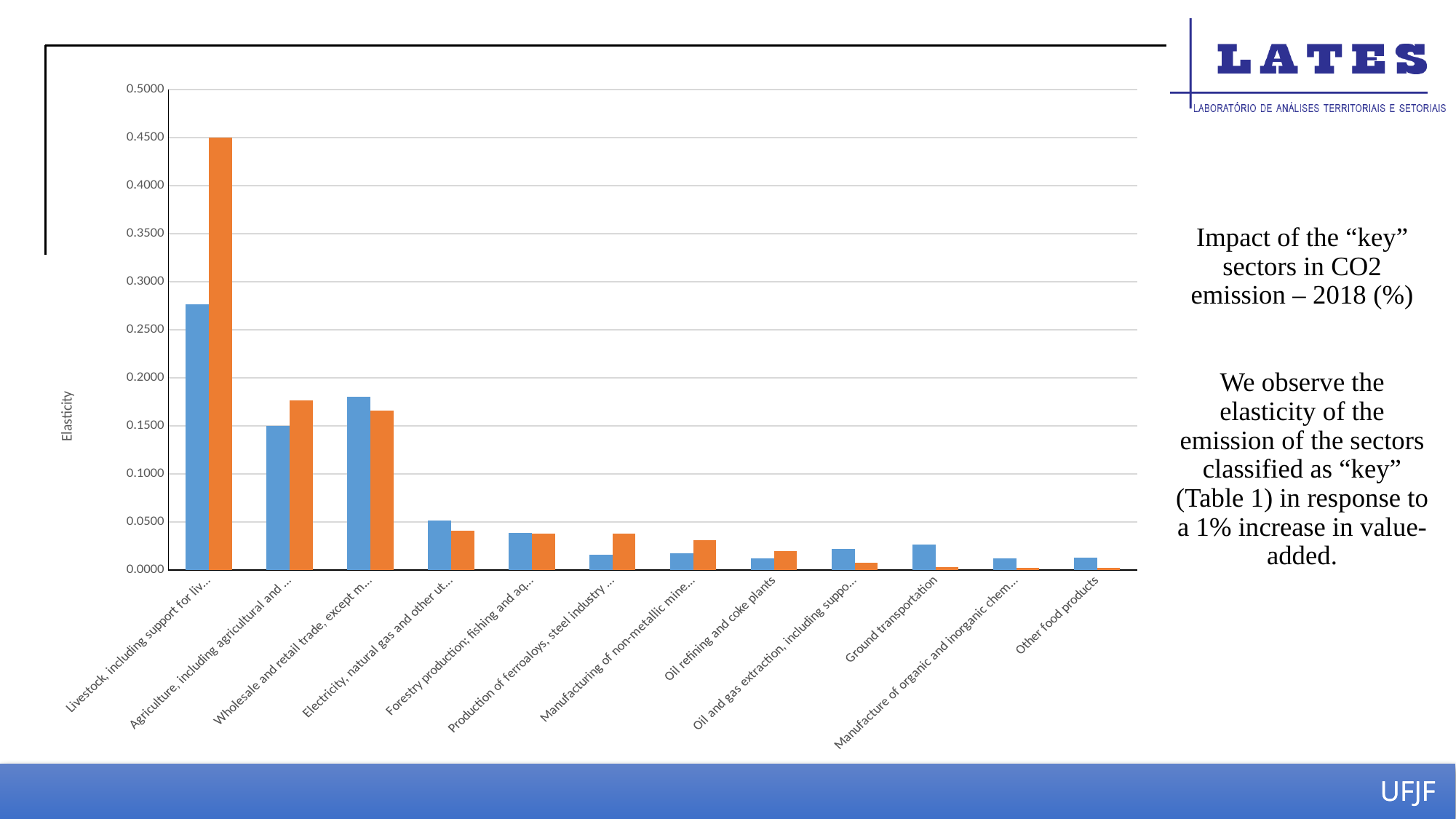
For Ground transportation, which bar is taller, the blue one or the orange one? blue What is the label of the vertical axis of the chart? Elasticity Is the orange bar for Ground transportation greater or less than 0.0500? less Which category has the tallest bar in the chart? Livestock, including support for liv... Do the bar heights generally rise or fall moving from left to right along the x axis? fall How many sector categories are shown on the x axis of the chart? 12 For Livestock, including support for liv..., which bar is taller, the blue one or the orange one? orange Is the blue bar for Livestock, including support for liv... greater or less than 0.3000? less What kind of chart is shown on the slide? bar chart Is the blue bar for Wholesale and retail trade, except m... greater or less than 0.1500? greater How many differently coloured bar series are plotted for each category? 2